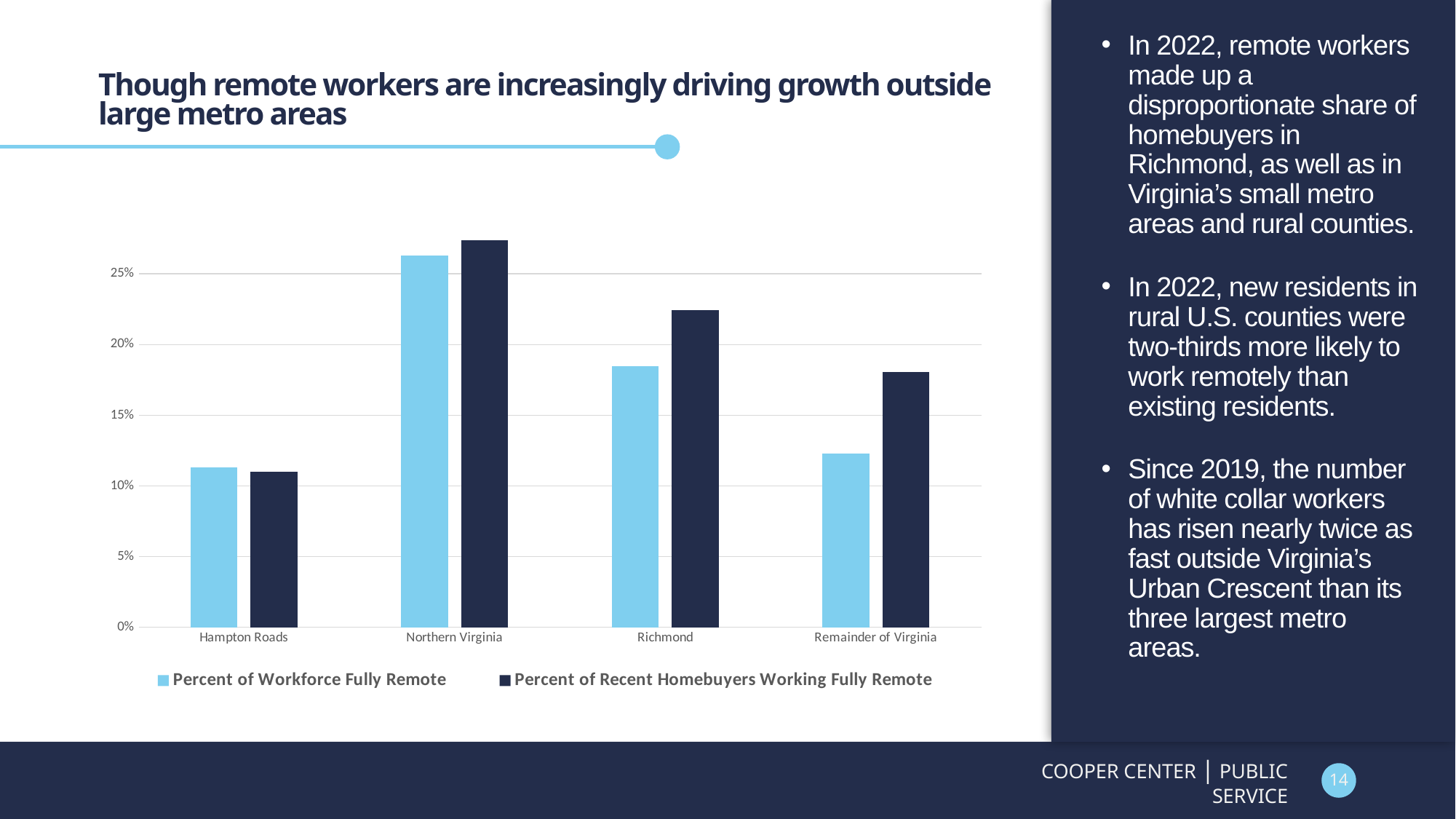
Is the value for Percent of Workforce Fully Remote in Northern Virginia greater or less than 25%? greater How many series does the chart's legend list? 2 What kind of chart is shown on the slide? bar chart Which series is shown in light blue in the chart's legend? Percent of Workforce Fully Remote In Remainder of Virginia, which is larger: Percent of Workforce Fully Remote or Percent of Recent Homebuyers Working Fully Remote? Percent of Recent Homebuyers Working Fully Remote Which category has the highest value for Percent of Workforce Fully Remote? Northern Virginia Which category has the highest value for Percent of Recent Homebuyers Working Fully Remote? Northern Virginia Is the value for Percent of Recent Homebuyers Working Fully Remote in Richmond greater or less than 20%? greater In Richmond, which is larger: Percent of Workforce Fully Remote or Percent of Recent Homebuyers Working Fully Remote? Percent of Recent Homebuyers Working Fully Remote How many categories are shown on the x axis of the chart? 4 Is the value for Percent of Workforce Fully Remote in Remainder of Virginia greater or less than 15%? less Which category has the lowest value for Percent of Recent Homebuyers Working Fully Remote? Hampton Roads